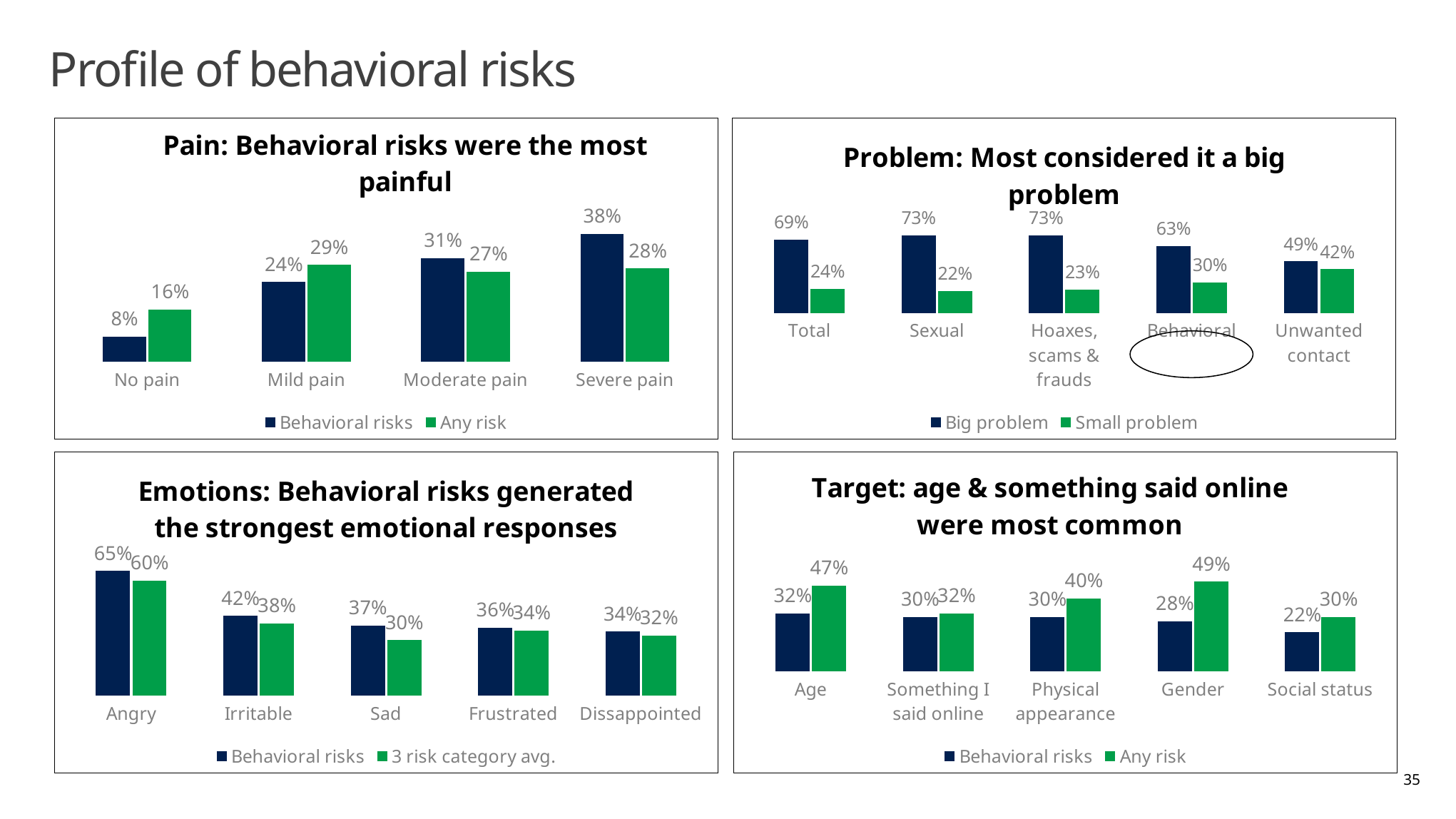
In the 'Target' chart (bottom right), is the Behavioral risks value for Age larger or smaller than the Any risk value for Age? smaller In the 'Pain' chart (top left), what is the value for Behavioral risks at Severe pain? 38% In the 'Problem' chart (top right), what is the Small problem value for Behavioral? 30% In the 'Emotions' chart (bottom left), which emotion has the highest Behavioral risks value? Angry In the 'Emotions' chart (bottom left), what are the two series listed in the legend? Behavioral risks and 3 risk category avg. In the 'Problem' chart (top right), which category has the lowest Big problem value? Unwanted contact In the 'Problem' chart (top right), how many categories are shown on the x axis? 5 In the 'Emotions' chart (bottom left), what is the 3 risk category avg. value for Sad? 30% In the 'Pain' chart (top left), what is the value for Any risk at No pain? 16% What type of chart is the 'Target' chart (bottom right)? Bar chart In the 'Pain' chart (top left), what is the difference between Behavioral risks and Any risk at Severe pain? 10% In the 'Target' chart (bottom right), which category has the highest Any risk value? Gender